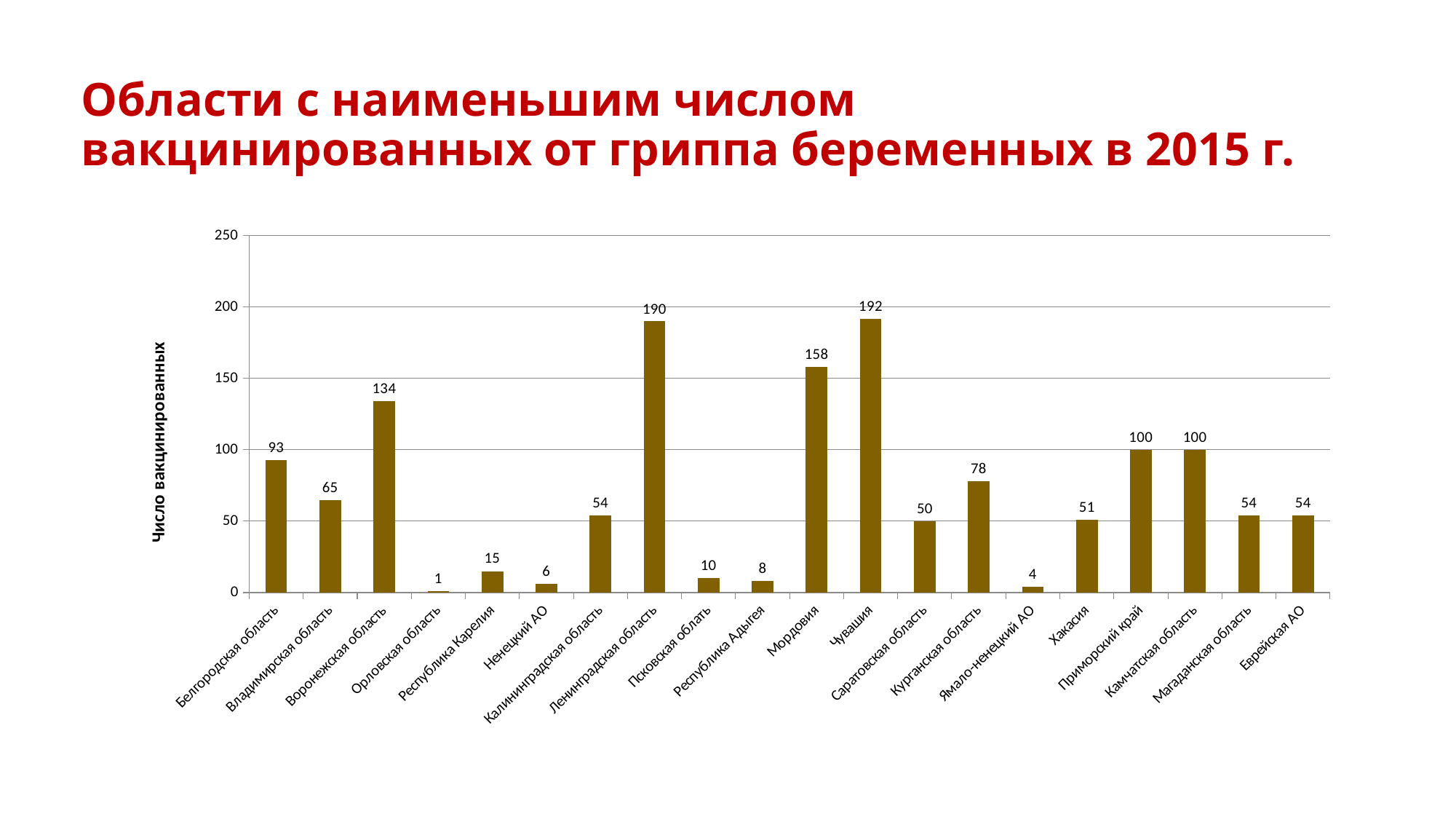
What is the difference between the values for Ленинградская область and Калининградская область? 136 What is the difference between the values for Чувашия and Мордовия? 34 What is the value for Воронежская область? 134 Which region has the lowest value? Орловская область What is the label of the vertical axis? Число вакцинированных Which region has the highest value? Чувашия Is the value for Белгородская область greater or less than 100? less Which is larger, the value for Курганская область or the value for Владимирская область? Курганская область How many regions are shown on the chart? 20 What kind of chart is shown on the slide? bar chart What is the value for Мордовия? 158 What is the value for Ямало-ненецкий АО? 4